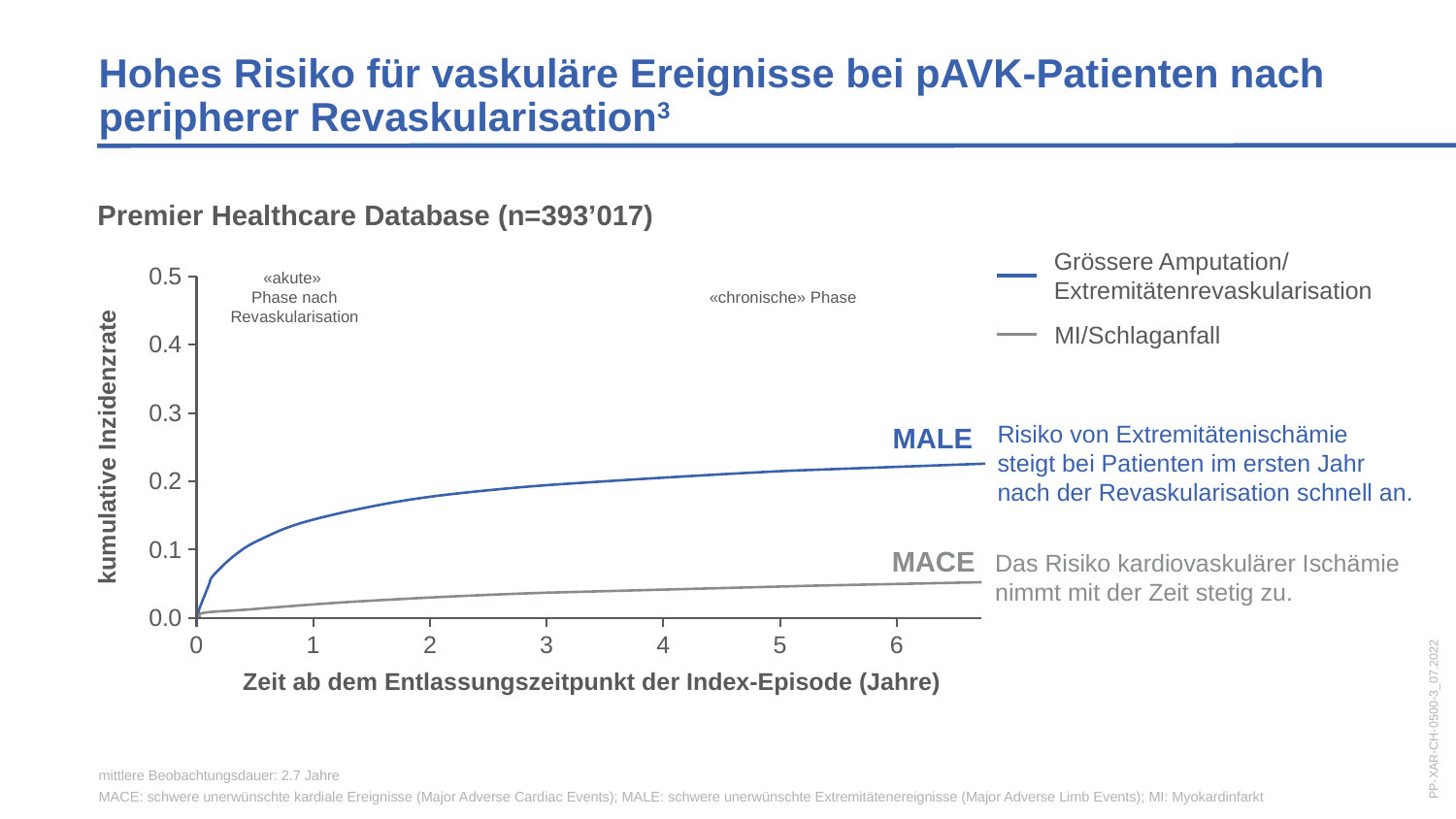
What is the label of the y axis? kumulative Inzidenzrate Which legend entry is shown in blue? Grössere Amputation/Extremitätenrevaskularisation Do the values of the MACE curve rise or fall along the x axis? rise Is the value for the MACE curve at year 6 greater or less than 0.1? less Is the value for the MALE curve at year 6 greater or less than 0.2? greater Do the values of the MALE curve rise or fall along the x axis? rise How many series does the legend list? 2 Is the value for the MALE curve at year 3 greater or less than 0.3? less What is the highest value shown on the y axis? 0.5 Which series has the higher cumulative incidence rate at year 6, MALE or MACE? MALE What kind of chart is shown on the slide? line chart